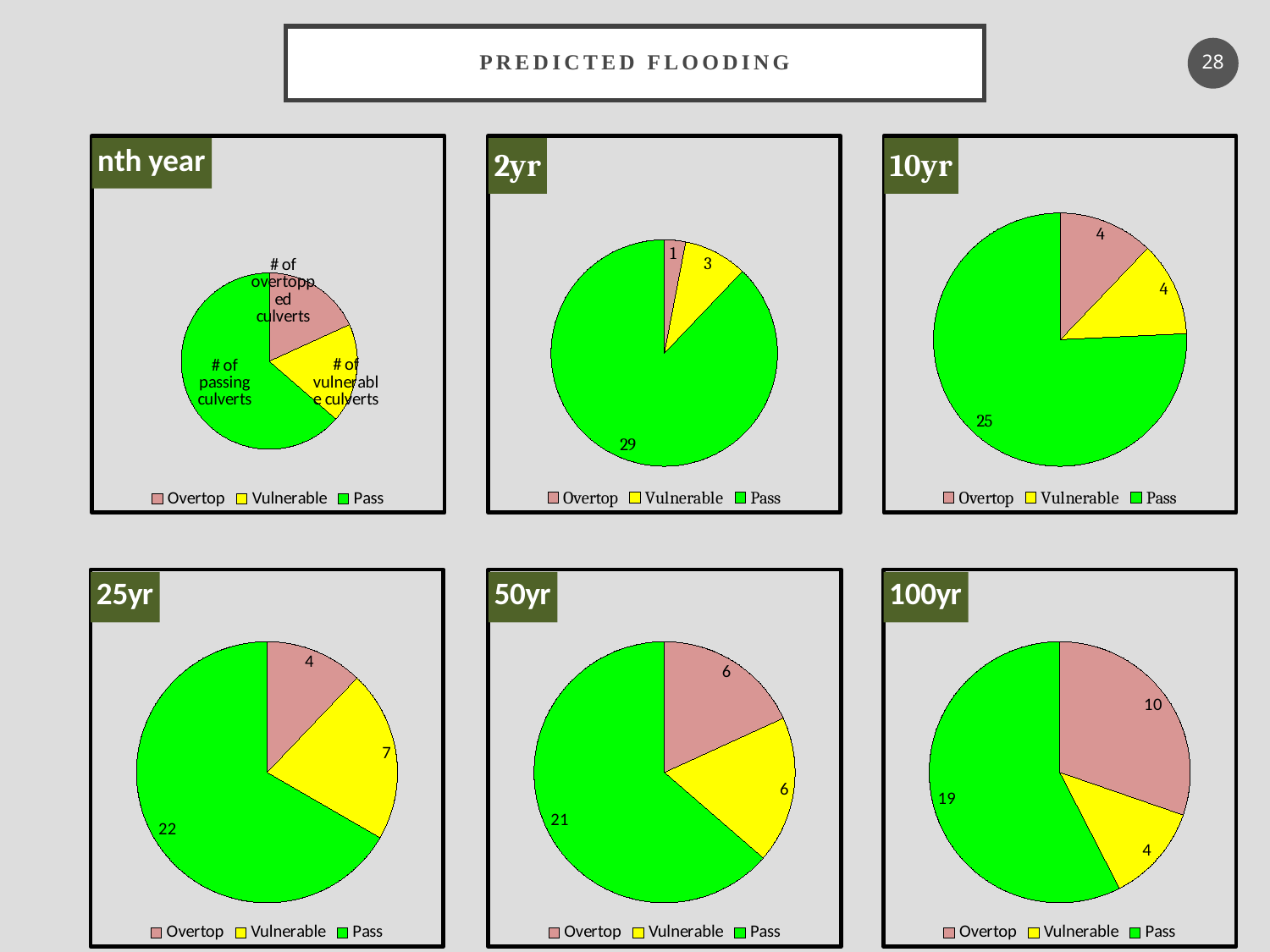
In the 25yr chart, which category has the smallest slice? Overtop In the 100yr chart, which category has the largest slice? Pass What kind of chart is the 2yr chart? pie chart In the 25yr chart, what is the value for Vulnerable? 7 In the 100yr chart, what is the difference between the Pass value and the Overtop value? 9 In the 10yr chart, what is the value for Overtop? 4 How many pie charts are shown on the slide? 6 How many categories does the legend of the 10yr chart list? 3 In the 50yr chart, what is the total of all three slices? 33 In the 100yr chart, what is the value for Overtop? 10 In the 2yr chart, how many culverts are in the Pass category? 29 In the 25yr chart, which is larger, Vulnerable or Overtop? Vulnerable